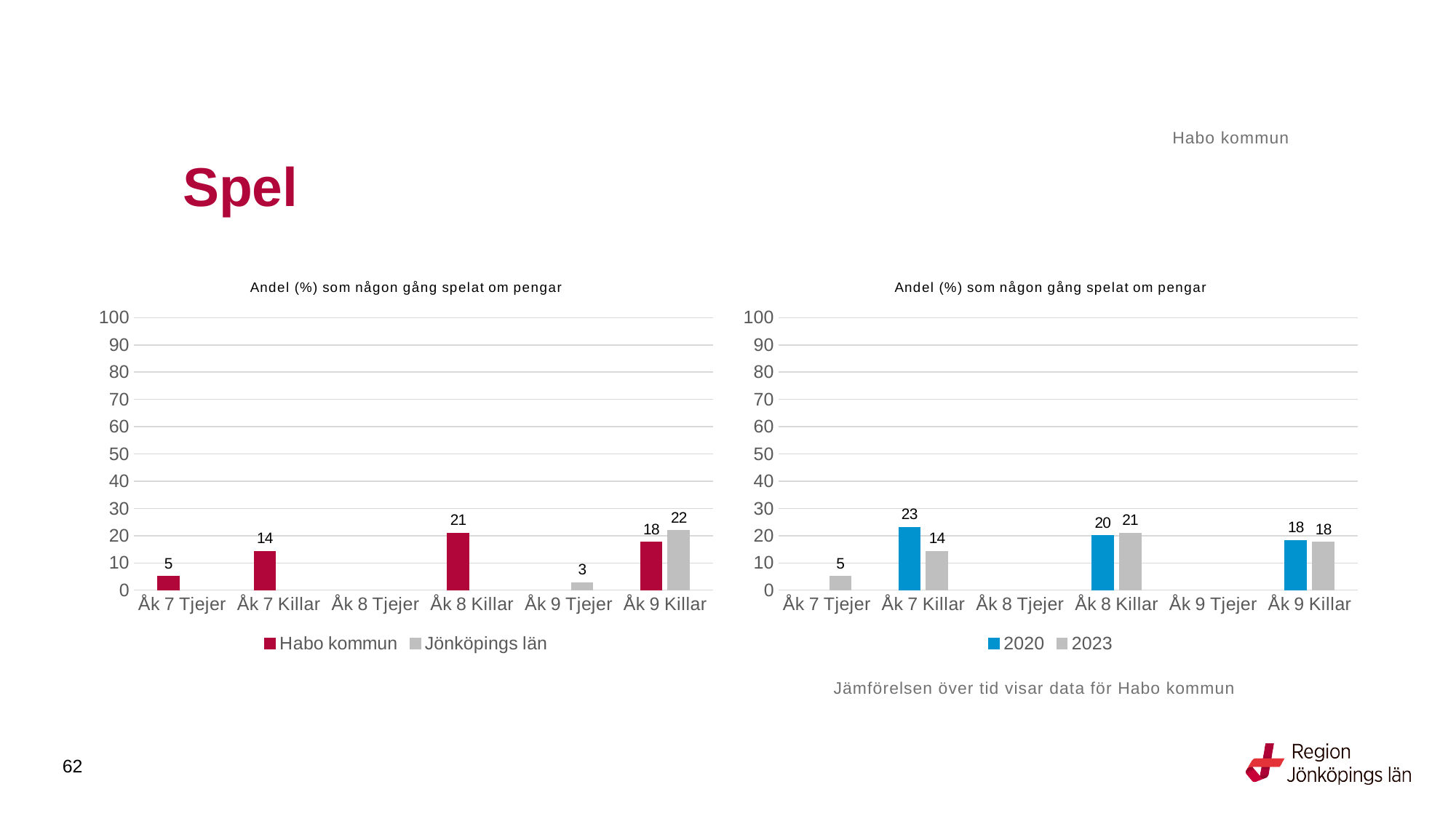
In the left chart, which is larger for Åk 9 Killar: Habo kommun or Jönköpings län? Jönköpings län In the left chart, which category has the highest Habo kommun value? Åk 8 Killar In the left chart, how many series does the legend list? 2 In the right chart, what is the 2023 value for Åk 8 Killar? 21 How many categories are shown on the x axis of the right chart? 6 In the left chart, what is the value for Jönköpings län for Åk 9 Tjejer? 3 In the right chart, what is the difference between the 2020 and 2023 values for Åk 7 Killar? 9 What kind of chart is the left chart? Bar chart In the right chart, what is the 2020 value for Åk 7 Killar? 23 In the left chart, what is the difference between Jönköpings län and Habo kommun for Åk 9 Killar? 4 In the right chart, which is larger for Åk 8 Killar: 2020 or 2023? 2023 In the left chart, what is the value for Habo kommun for Åk 8 Killar? 21